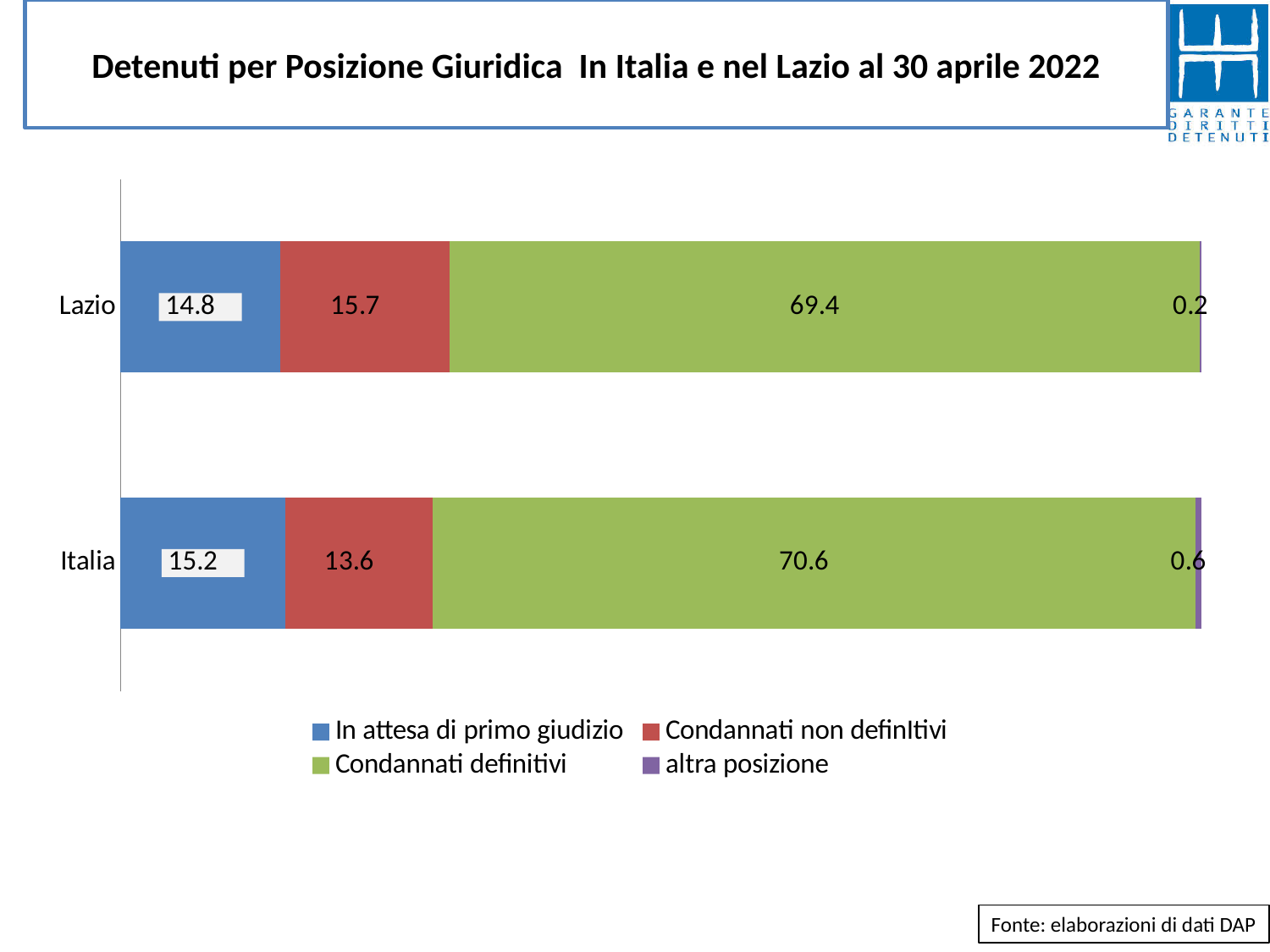
Which category has the higher value for 'Condannati non definitivi', Lazio or Italia? Lazio What is the value for 'Condannati non definitivi' for Lazio? 15.7 What is the value for 'Condannati definitivi' for Italia? 70.6 How many series does the legend list? 4 Which category has the higher value for 'Condannati definitivi', Lazio or Italia? Italia What is the difference between the 'Condannati non definitivi' values for Lazio and Italia? 2.1 What kind of chart is shown on the slide? Stacked bar chart What is the value for 'altra posizione' for Italia? 0.6 How many categories are shown on the chart? 2 What is the difference between the 'Condannati definitivi' values for Italia and Lazio? 1.2 What is the value for 'In attesa di primo giudizio' for Lazio? 14.8 What is the title of the chart? Detenuti per Posizione Giuridica In Italia e nel Lazio al 30 aprile 2022